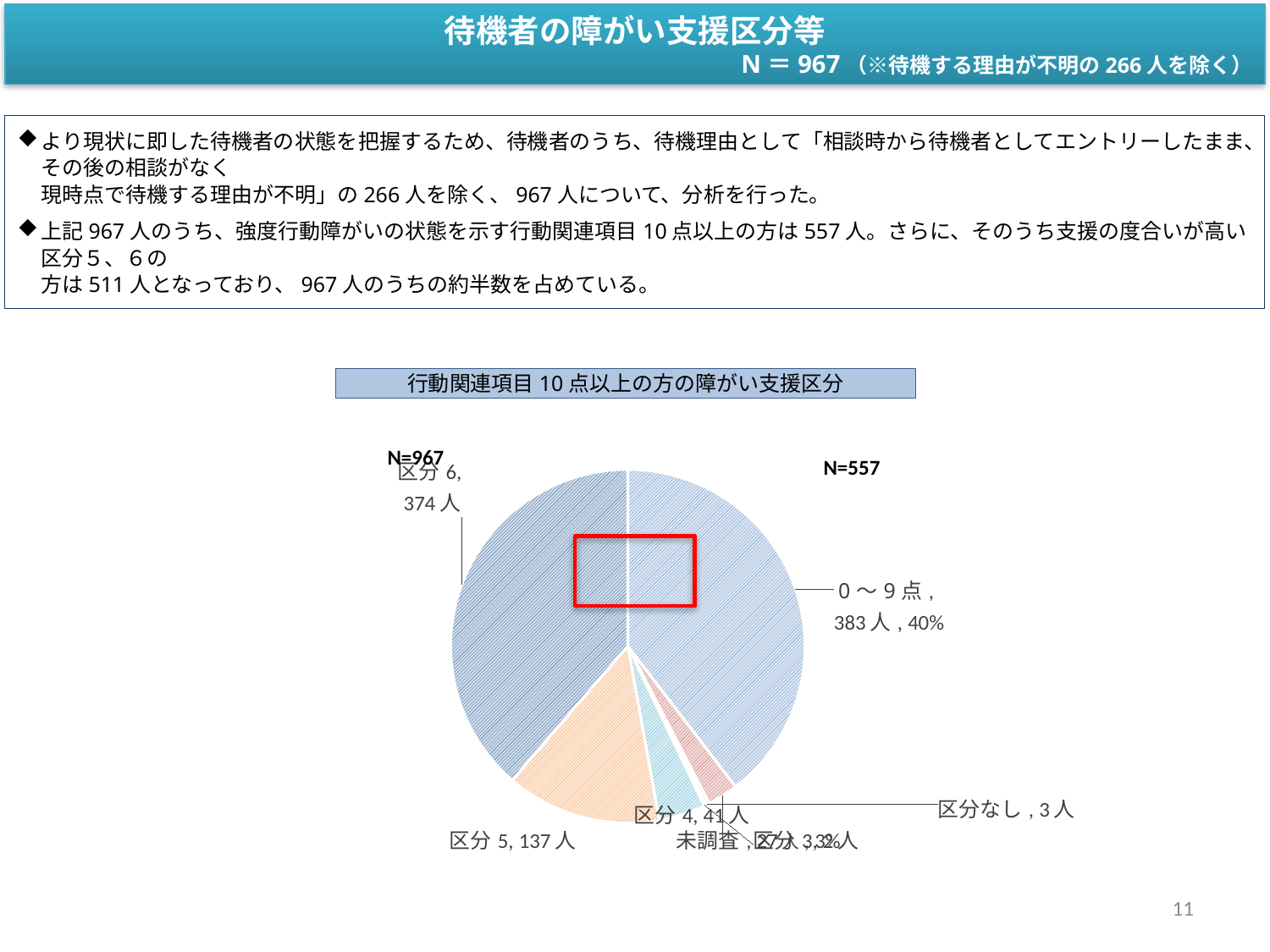
Which slice of the pie chart has the largest number of people? 0～9点 Which slice has more people, 区分5 or 区分4? 区分5 What is the difference in people between the 区分5 slice and the 区分4 slice? 96人 How many people are in the 区分4 slice of the pie chart? 41人 How many people are in the 0～9点 slice of the pie chart? 383人 What kind of chart is shown on the slide? pie chart What share of the pie does the 0～9点 slice represent? 40% How many people are in the 区分5 slice of the pie chart? 137人 How many people are in the 区分6 slice of the pie chart? 374人 What is the title shown above the pie chart? 行動関連項目10点以上の方の障がい支援区分 How many people are in the 区分なし slice of the pie chart? 3人 What is the difference in people between the 区分6 slice and the 区分5 slice? 237人